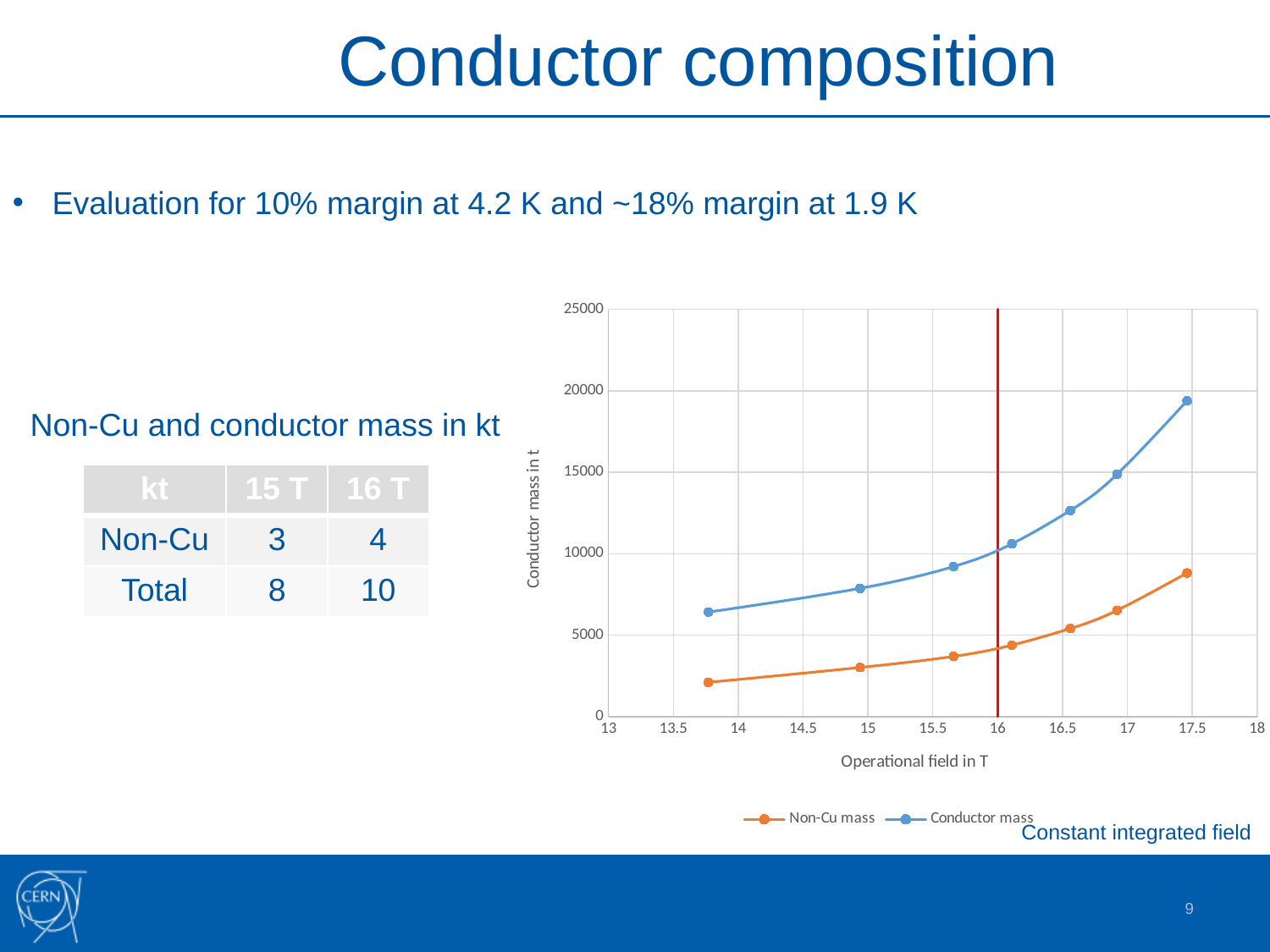
Is the value of the leftmost Conductor mass point greater or less than 5000? greater Do the values of the Non-Cu mass series rise or fall as the operational field increases? rise Is the value of the rightmost Conductor mass point greater or less than 15000? greater What kind of chart is shown on the slide? line chart Do the values of the Conductor mass series rise or fall as the operational field increases? rise Is the value of the rightmost Non-Cu mass point greater or less than 10000? less What are the two series named in the chart legend? Non-Cu mass and Conductor mass How many data points are plotted for the Conductor mass series? 7 Which series has the higher values across the chart, Non-Cu mass or Conductor mass? Conductor mass How many series does the chart legend list? 2 What is the title of the chart's x axis? Operational field in T